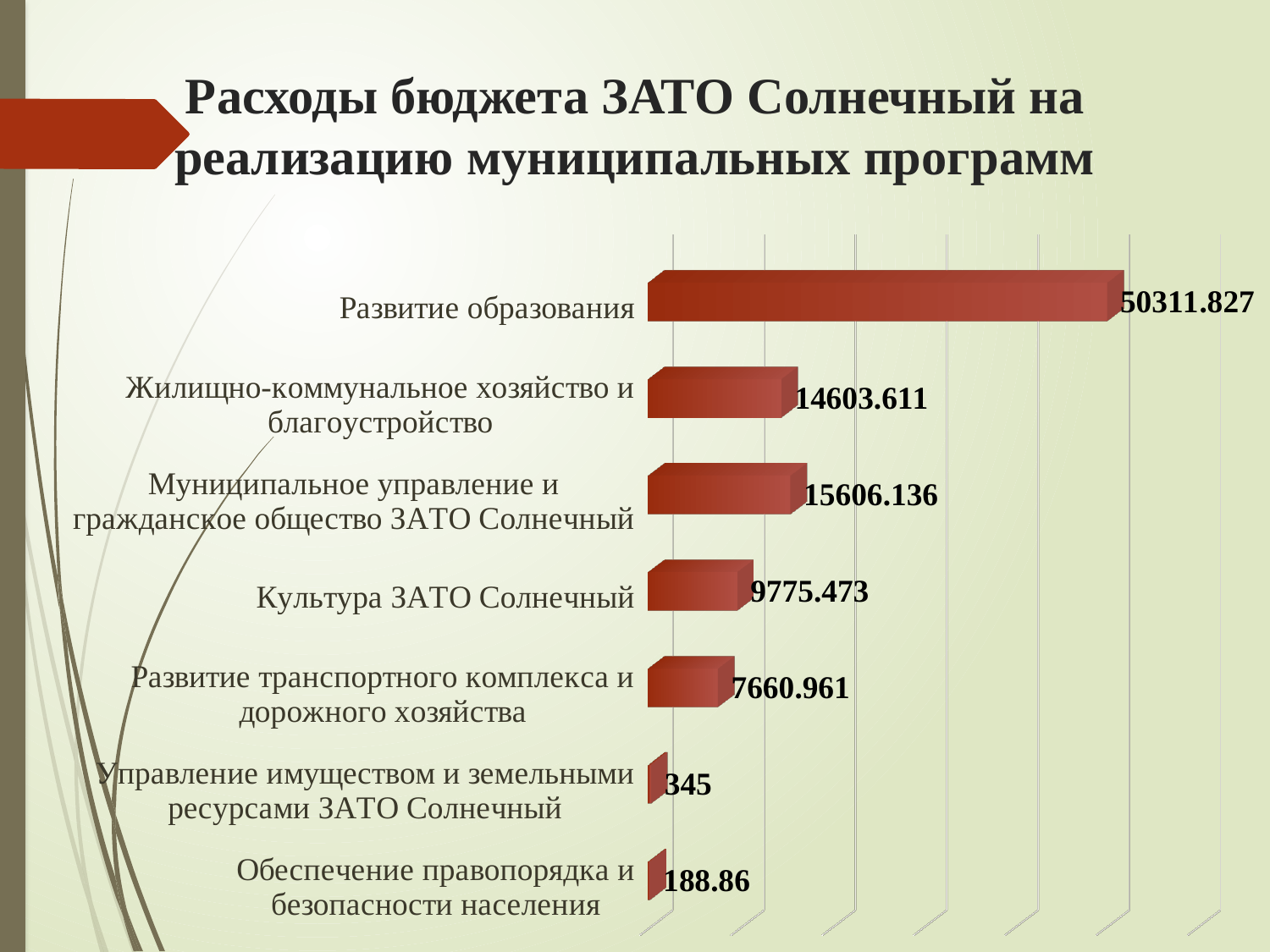
What is the value for Культура ЗАТО Солнечный? 9775.473 What type of chart is shown on the slide? Bar chart Which category has the lowest value? Обеспечение правопорядка и безопасности населения How many categories are shown in the chart? 7 Which is larger: the value for Культура ЗАТО Солнечный or the value for Развитие транспортного комплекса и дорожного хозяйства? Культура ЗАТО Солнечный What is the value for Развитие образования? 50311.827 What is the difference between the values for Развитие образования and Жилищно-коммунальное хозяйство и благоустройство? 35708.216 Which category has the highest value? Развитие образования What is the difference between the values for Муниципальное управление и гражданское общество ЗАТО Солнечный and Жилищно-коммунальное хозяйство и благоустройство? 1002.525 What is the title of the slide containing the chart? Расходы бюджета ЗАТО Солнечный на реализацию муниципальных программ What is the value for Обеспечение правопорядка и безопасности населения? 188.86 What is the value for Управление имуществом и земельными ресурсами ЗАТО Солнечный? 345